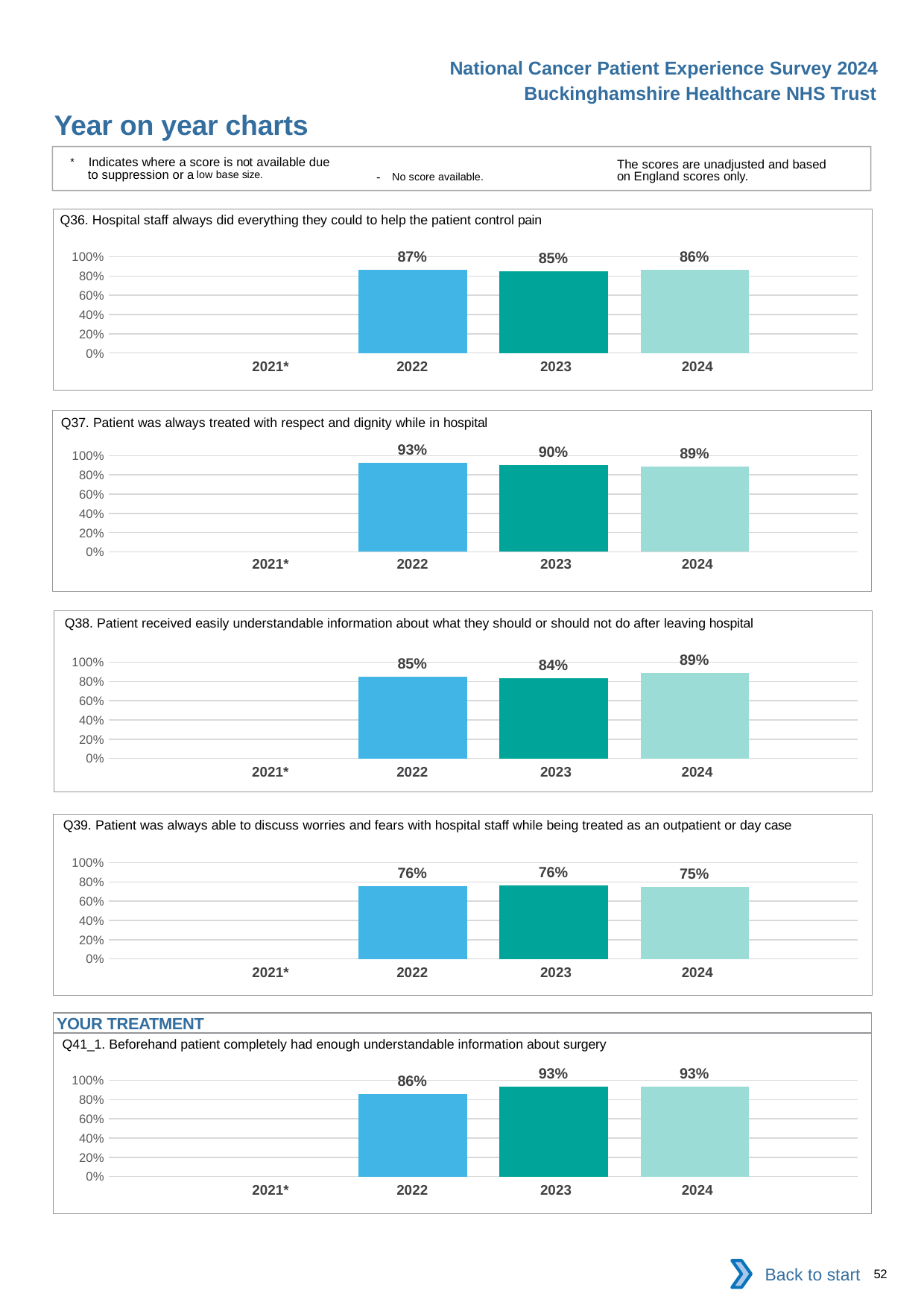
In the Q36 chart, how many years have a bar plotted? 3 In the Q39 chart, is the value for 2022 greater or less than 60%? greater In the Q39 chart, what is the value for 2024? 75% In the Q36 chart, what is the value for 2022? 87% In the Q41_1 chart, what is the value for 2023? 93% In the Q37 chart, is the value for 2023 larger or smaller than the value for 2024? larger In the Q36 chart, what is the difference between the 2022 and 2023 values? 2% In the Q41_1 chart, which year has the lowest value? 2022 In the Q38 chart, what is the difference between the 2024 and 2023 values? 5% In the Q37 chart, do the values rise or fall from 2022 to 2024? fall What kind of chart is the Q38 chart? bar chart In the Q37 chart, which year has the highest value? 2022